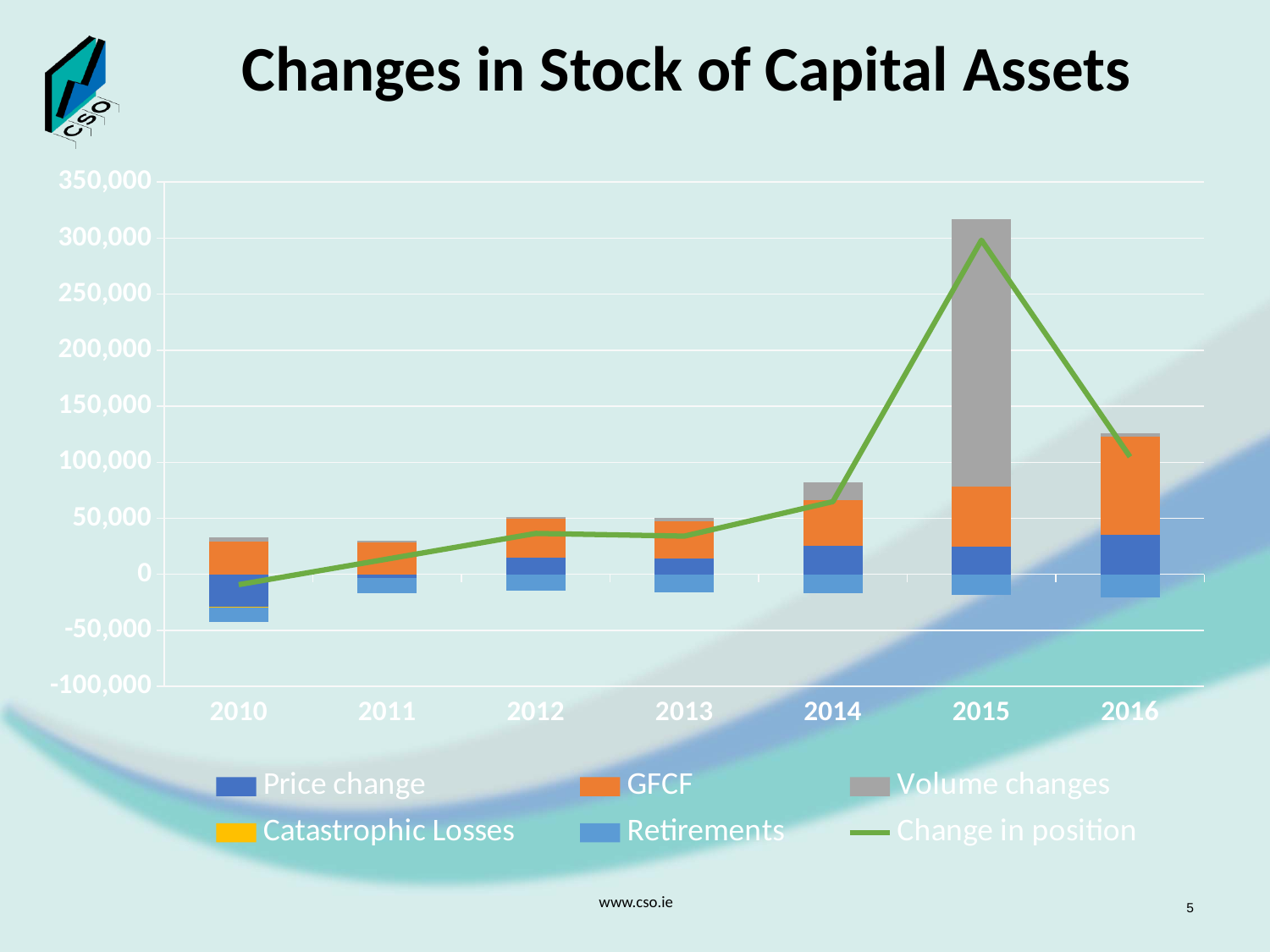
Which year has the tallest stacked bar above zero? 2015 Is the Change in position value for 2014 greater or less than 50,000? greater Which series is plotted as a line rather than as bars? Change in position In which year is the Change in position line at its lowest value? 2010 Does the Change in position line rise or fall from 2010 to 2015? rise What is the title of the chart? Changes in Stock of Capital Assets Is the Change in position value for 2016 greater or less than 150,000? less In which year does the Change in position line reach its highest value? 2015 What kind of chart is shown on the slide? A stacked bar chart with a line How many series does the legend list? 6 How many years are shown on the x axis of the chart? 7 Is the Change in position value for 2015 greater or less than 250,000? greater